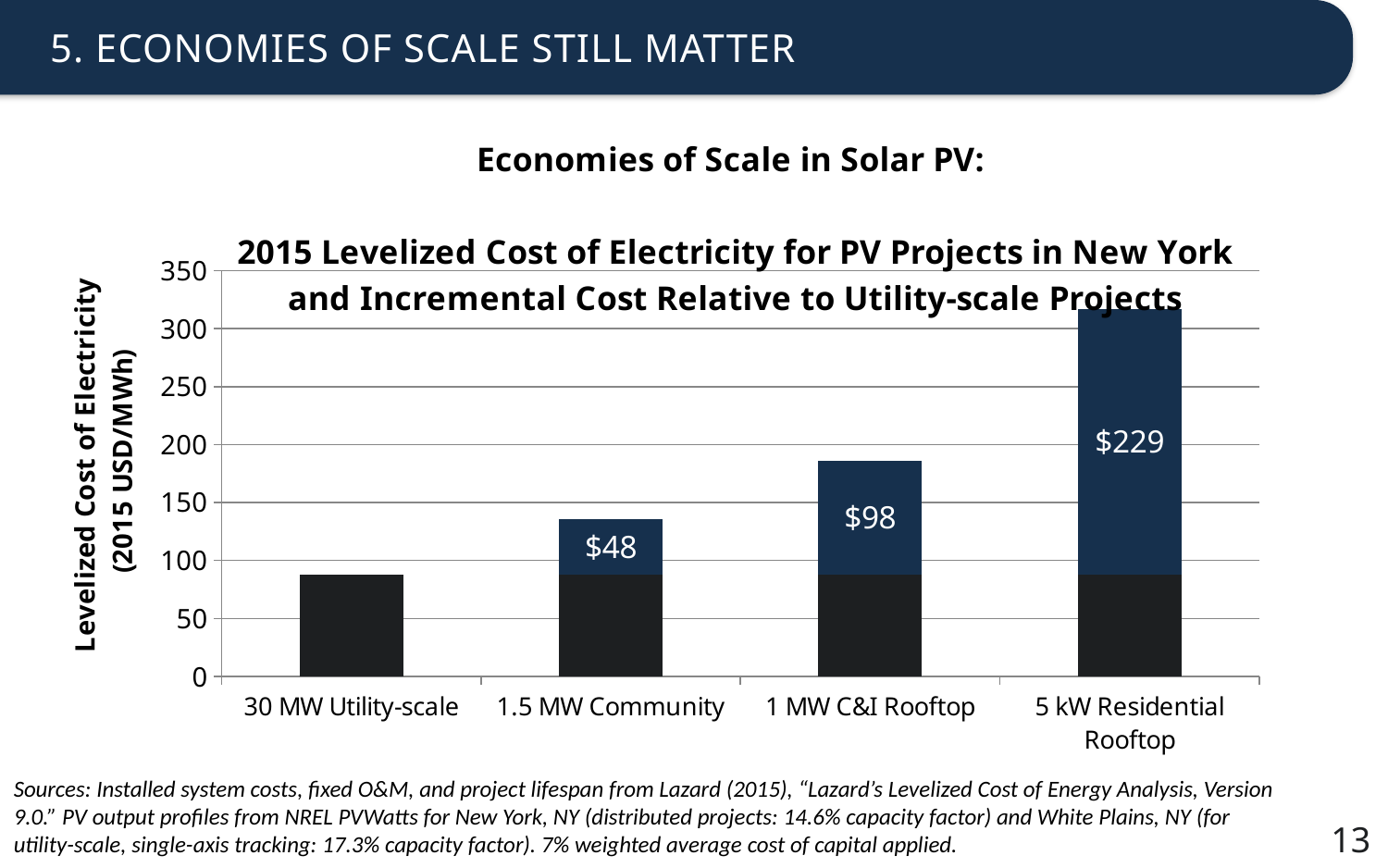
What is the difference between the labeled incremental costs for 5 kW Residential Rooftop and 1 MW C&I Rooftop? $131 How many project categories are shown on the x axis? 4 Is the total bar height for 5 kW Residential Rooftop greater or less than 300? greater What type of chart is shown on the slide? Stacked bar chart Which has a larger labeled incremental cost: 1 MW C&I Rooftop or 1.5 MW Community? 1 MW C&I Rooftop Is the total bar height for 30 MW Utility-scale greater or less than 100? less What is the incremental cost label shown on the bar for 1 MW C&I Rooftop? $98 Do the total bar heights rise or fall moving from 30 MW Utility-scale to 5 kW Residential Rooftop? Rise Among the categories with a labeled incremental cost, which has the smallest? 1.5 MW Community What is the incremental cost label shown on the bar for 1.5 MW Community? $48 Which category has the largest labeled incremental cost relative to utility-scale projects? 5 kW Residential Rooftop What is the incremental cost label shown on the bar for 5 kW Residential Rooftop? $229